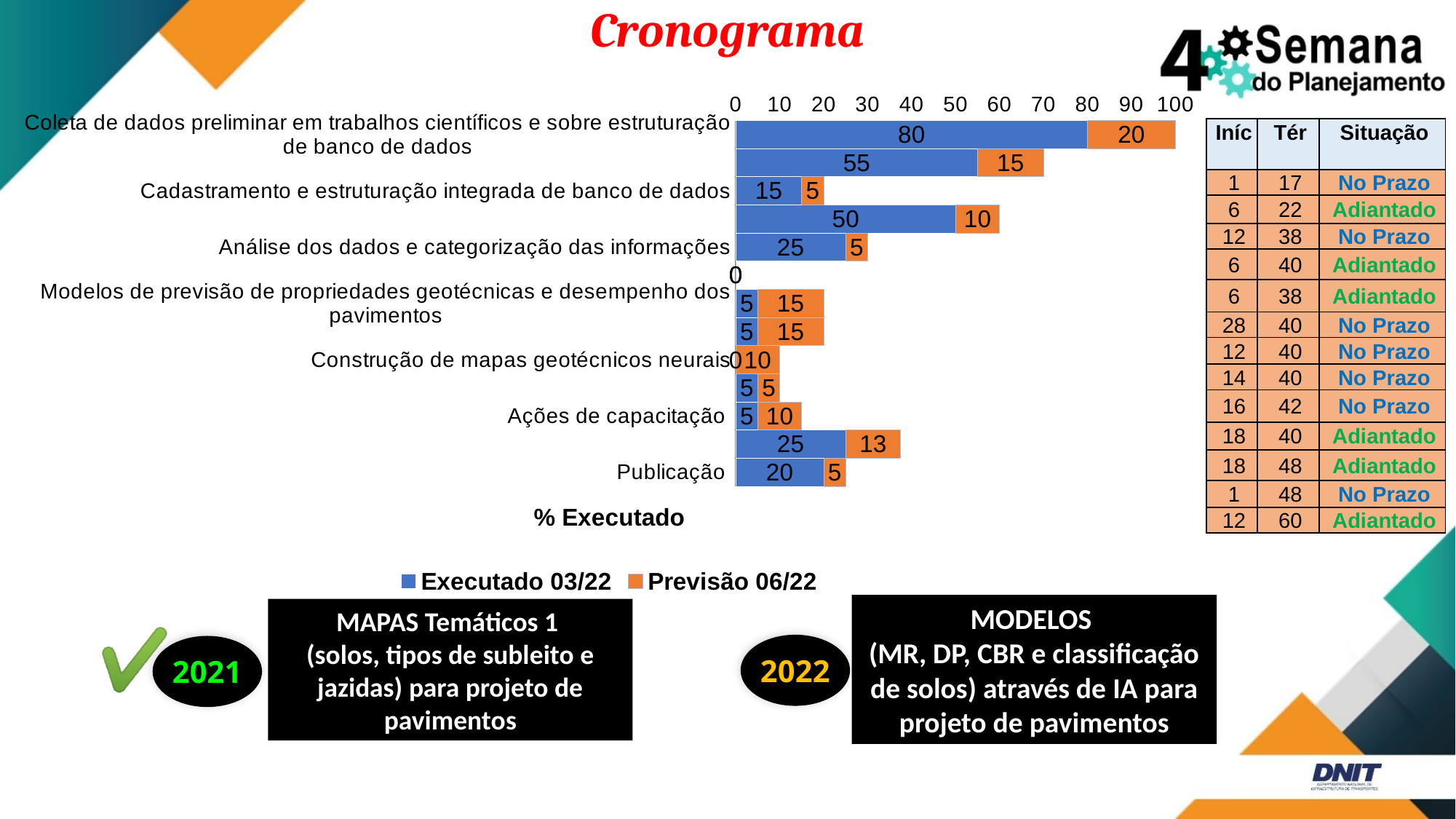
What is the difference between the Executado 03/22 values for 'Coleta de dados preliminar em trabalhos científicos e sobre estruturação de banco de dados' and 'Publicação'? 60 What are the two series named in the chart legend? Executado 03/22 and Previsão 06/22 What is the Executado 03/22 value for 'Coleta de dados preliminar em trabalhos científicos e sobre estruturação de banco de dados'? 80 What is the total of the stacked bar for 'Análise dos dados e categorização das informações'? 30 How many series does the chart legend list? 2 Which labelled category has the highest Executado 03/22 value? Coleta de dados preliminar em trabalhos científicos e sobre estruturação de banco de dados What type of chart is shown on the slide? bar chart What is the total of the stacked bar for 'Ações de capacitação'? 15 What is the Previsão 06/22 value for 'Modelos de previsão de propriedades geotécnicas e desempenho dos pavimentos'? 15 What is the Previsão 06/22 value for 'Coleta de dados preliminar em trabalhos científicos e sobre estruturação de banco de dados'? 20 What is the Executado 03/22 value for 'Publicação'? 20 What is the Executado 03/22 value for 'Cadastramento e estruturação integrada de banco de dados'? 15